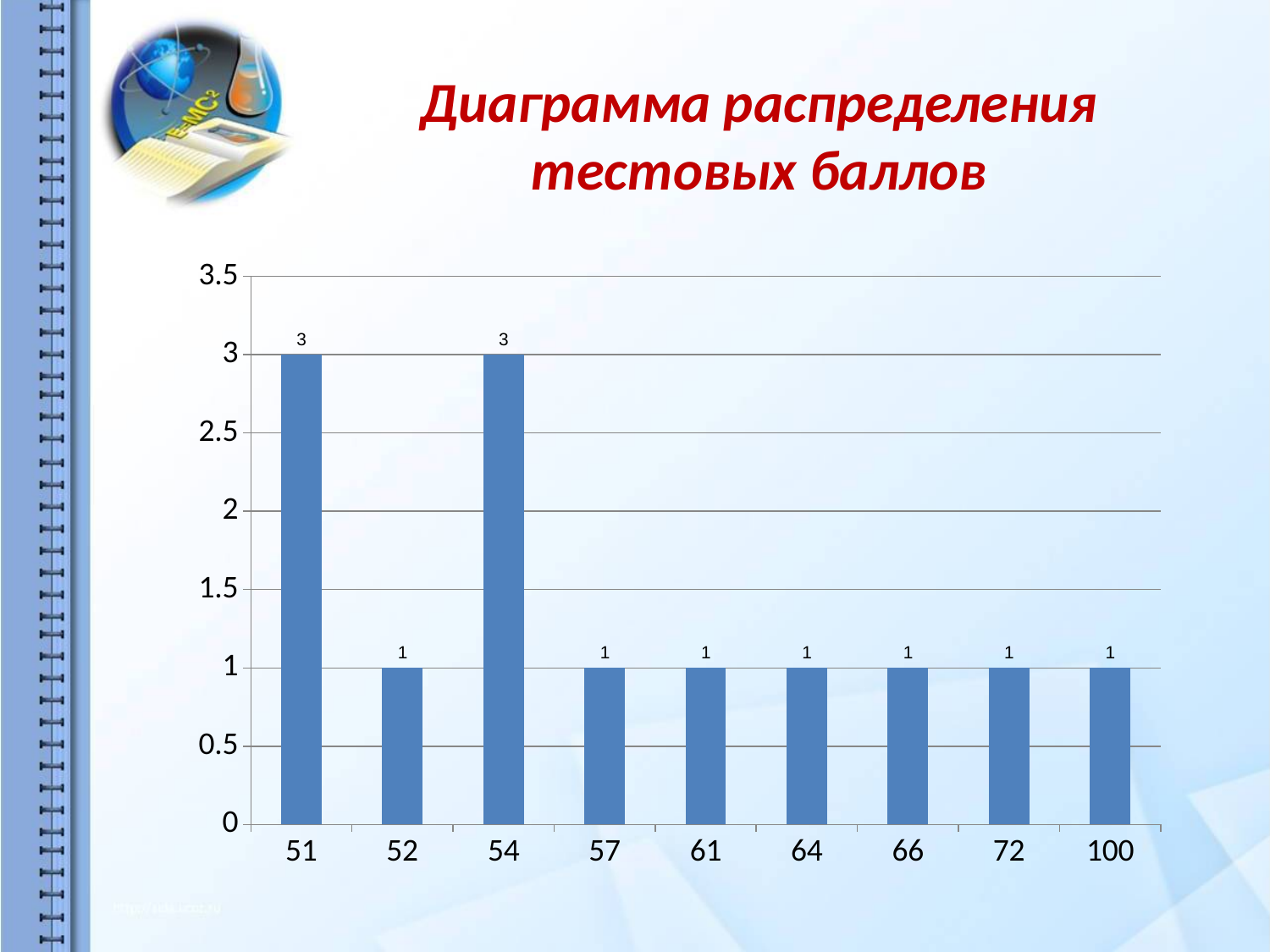
What is the highest value shown on the y axis? 3.5 Is the value for 72 greater or less than 2? less What is the value for category 100? 1 Is the value for 51 greater or less than 2? greater How many categories are shown on the x axis? 9 What is the value for category 54? 3 What is the value for category 51? 3 Which is larger, the value for 54 or the value for 57? 54 What is the difference between the values for 51 and 52? 2 What is the value for category 66? 1 What is the title of the slide? Диаграмма распределения тестовых баллов What kind of chart is shown on the slide? bar chart